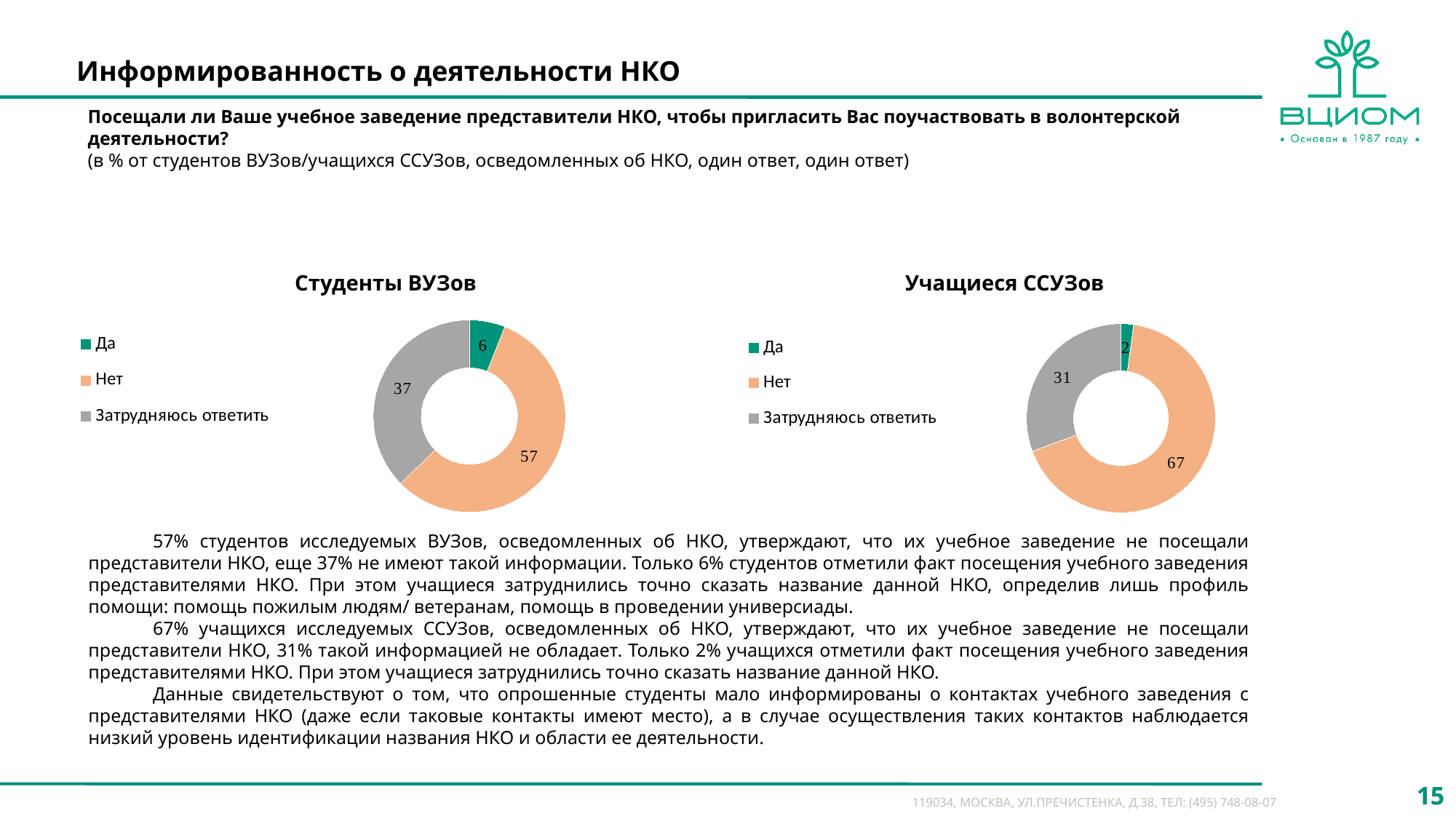
In the 'Студенты ВУЗов' chart, what is the difference between 'Нет' and 'Затрудняюсь ответить'? 20 In the 'Учащиеся ССУЗов' chart, what is the difference between 'Нет' and 'Да'? 65 In the 'Студенты ВУЗов' chart, which category has the largest share? Нет In the 'Студенты ВУЗов' chart, what is the value for 'Да'? 6 In the 'Студенты ВУЗов' chart, what colour represents 'Затрудняюсь ответить'? Grey In the 'Учащиеся ССУЗов' chart, what is the value for 'Затрудняюсь ответить'? 31 What type of chart is the 'Учащиеся ССУЗов' chart? Doughnut chart How many categories does the 'Студенты ВУЗов' chart show? 3 Which is larger: 'Да' in the 'Студенты ВУЗов' chart or 'Да' in the 'Учащиеся ССУЗов' chart? Студенты ВУЗов In the 'Учащиеся ССУЗов' chart, what is the value for 'Нет'? 67 In the 'Учащиеся ССУЗов' chart, which category has the smallest share? Да In the 'Студенты ВУЗов' chart, what is the value for 'Нет'? 57